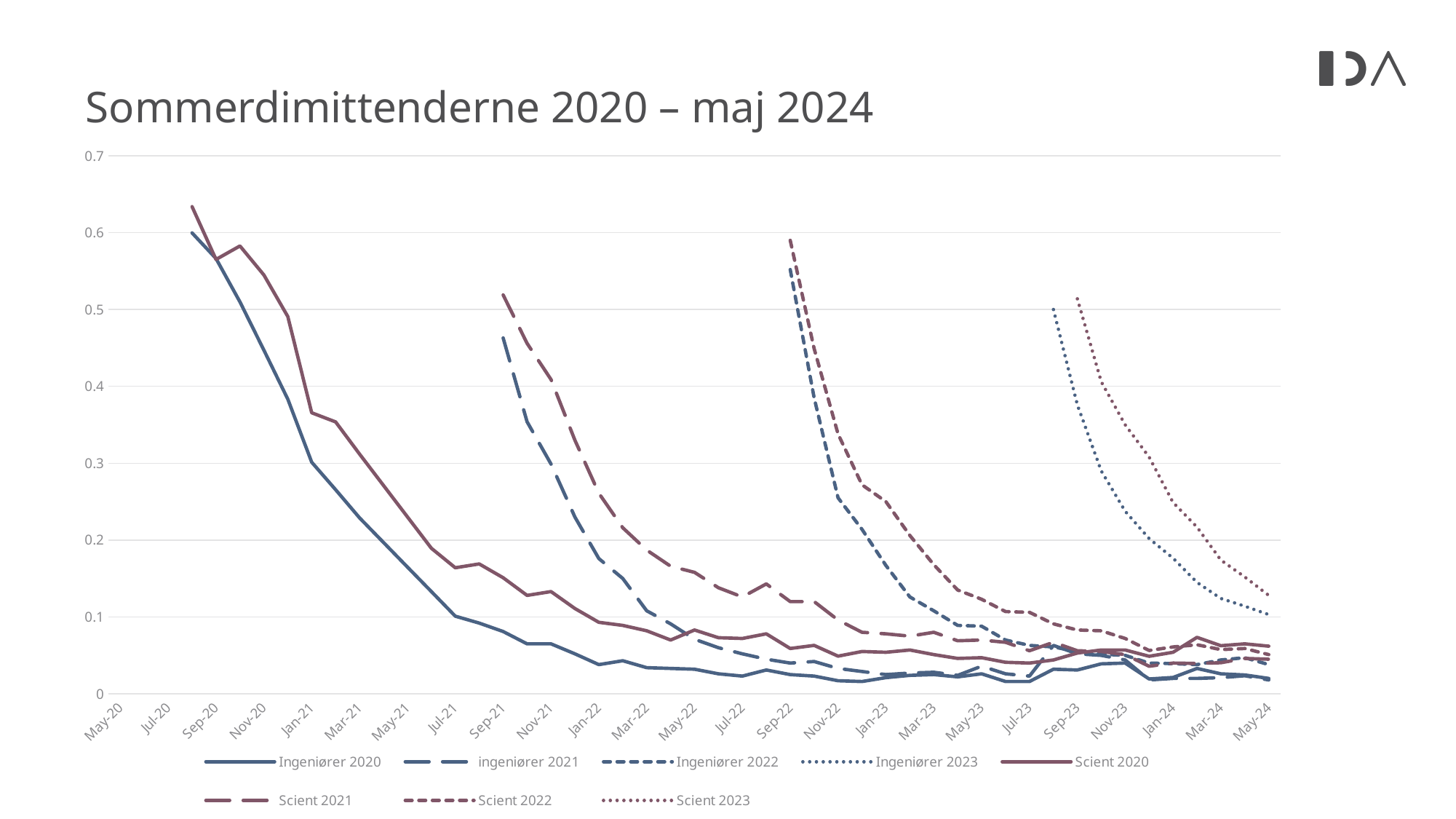
Is the value for ingeniører 2021 at Sep-21 greater or less than 0.5? less Is the value for Scient 2020 at Jan-21 greater or less than 0.3? greater How many series does the legend list? 8 Is the value for Scient 2023 at May-24 greater or less than 0.1? greater What kind of chart is shown on the slide? Line chart Does the Scient 2023 line rise or fall from Sep-23 to May-24? Fall What is the title of the chart? Sommerdimittenderne 2020 – maj 2024 At Mar-24, which is higher: Scient 2023 or Ingeniører 2023? Scient 2023 Does the Ingeniører 2020 line rise or fall from Sep-20 to May-24? Fall Which series reaches the highest value anywhere on the chart? Scient 2020